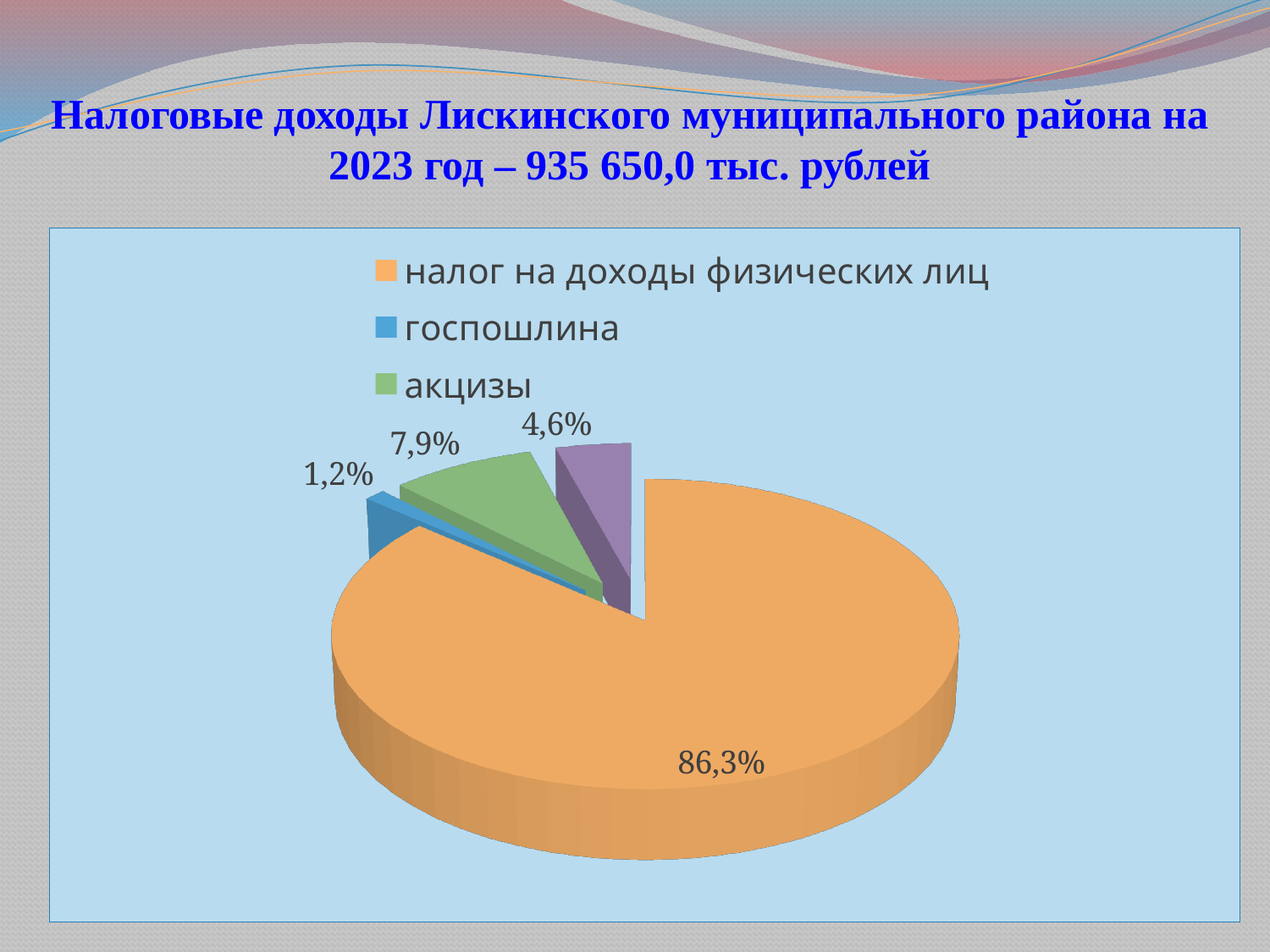
Which is larger, the slice for акцизы or the slice for госпошлина? акцизы Which category has the smallest slice of the pie? госпошлина How many slices does the pie chart have? 4 What is the value shown for акцизы? 7,9% How many entries does the legend list? 3 What colour is the slice for налог на доходы физических лиц? orange Which category has the largest slice of the pie? налог на доходы физических лиц What is the difference between the shares of акцизы and госпошлина? 6,7% What is the value shown for госпошлина? 1,2% By how many percentage points does налог на доходы физических лиц exceed акцизы? 78,4% What kind of chart is shown on the slide? pie chart What share of the pie does налог на доходы физических лиц account for? 86,3%